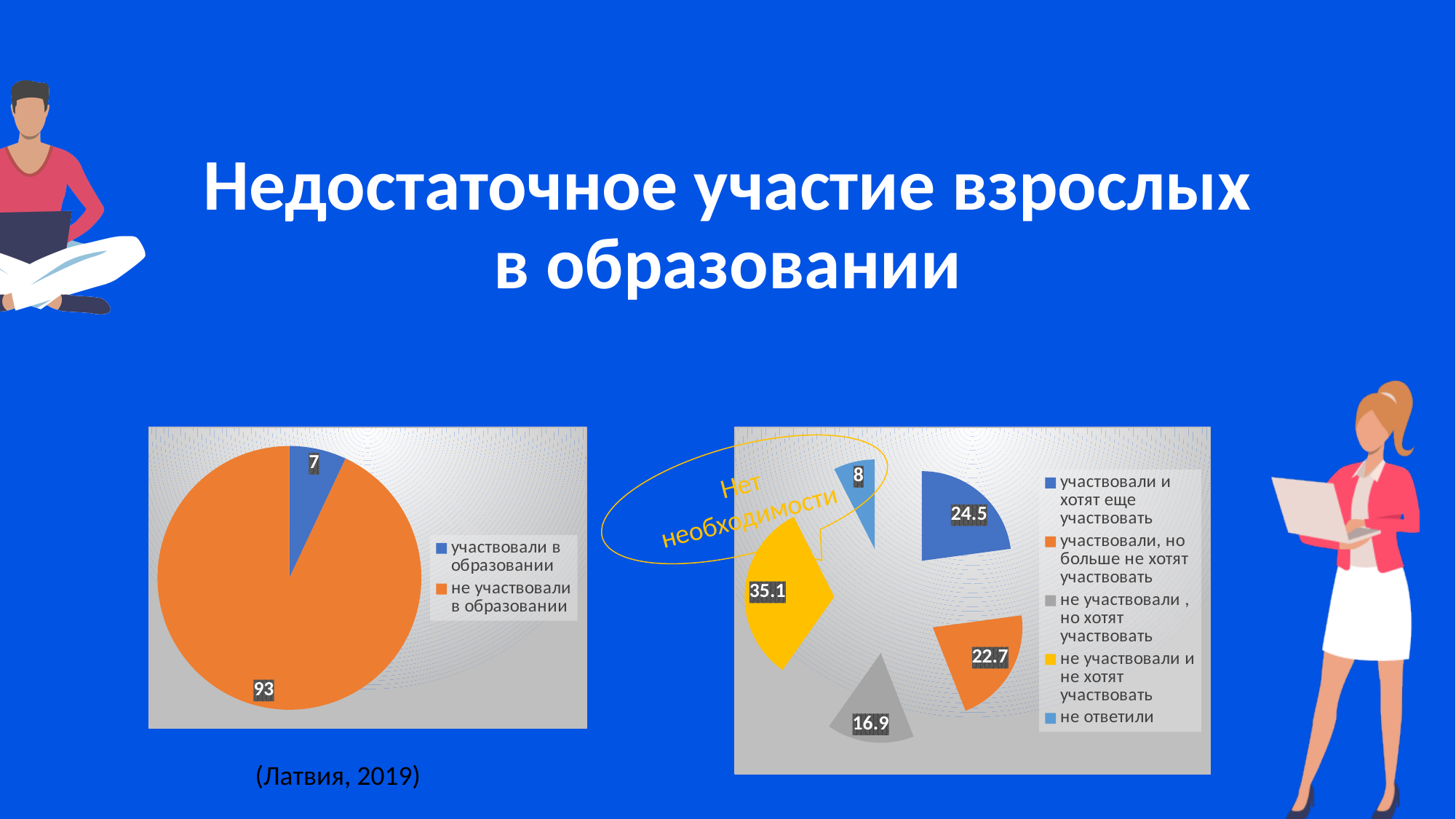
In the right pie chart, which category has the smallest value? не ответили What kind of chart is the left chart on the slide? Pie chart In the left pie chart, what is the value for 'участвовали в образовании'? 7 How many entries does the legend of the right pie chart list? 5 In the right pie chart, which is larger: 'участвовали и хотят еще участвовать' or 'не участвовали, но хотят участвовать'? участвовали и хотят еще участвовать In the left pie chart, what is the value for 'не участвовали в образовании'? 93 In the right pie chart, what is the value for 'не участвовали и не хотят участвовать'? 35.1 In the right pie chart, what is the difference between the values for 'участвовали и хотят еще участвовать' and 'участвовали, но больше не хотят участвовать'? 1.8 In the right pie chart, which category has the largest value? не участвовали и не хотят участвовать In the right pie chart, what is the value for 'не ответили'? 8 In the right pie chart, what is the value for 'участвовали, но больше не хотят участвовать'? 22.7 In the left pie chart, what is the difference between the values for 'не участвовали в образовании' and 'участвовали в образовании'? 86